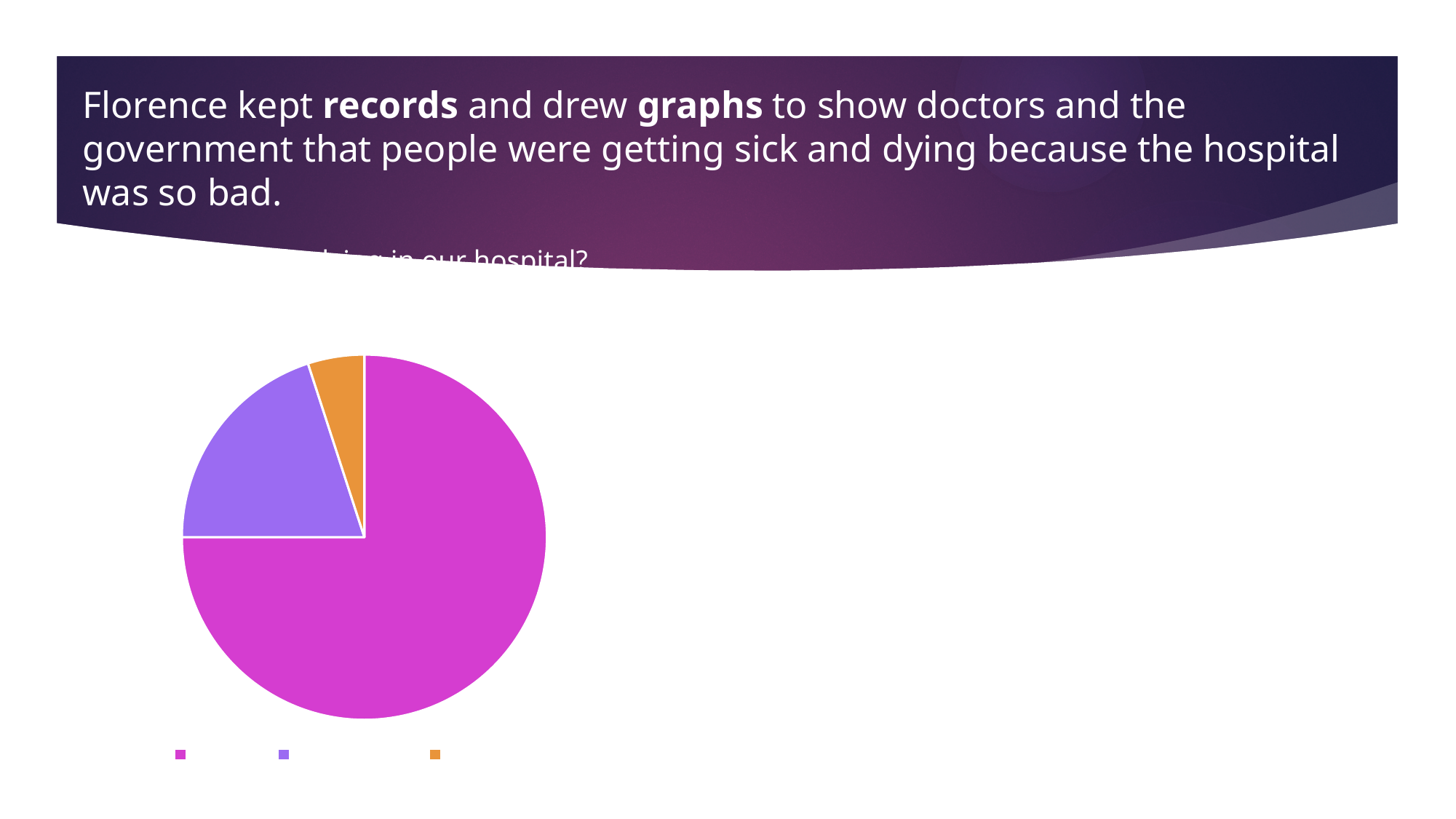
Which colour slice is the largest in the pie chart? magenta Which slice is larger in the pie chart, the purple one or the orange one? purple What kind of chart is shown on the slide? pie chart Which colour slice is the smallest in the pie chart? orange How many slices does the pie chart have? 3 Which slice is larger in the pie chart, the magenta one or the purple one? magenta How many entries does the legend of the pie chart list? 3 Does the magenta slice take up more or less than half of the pie chart? more